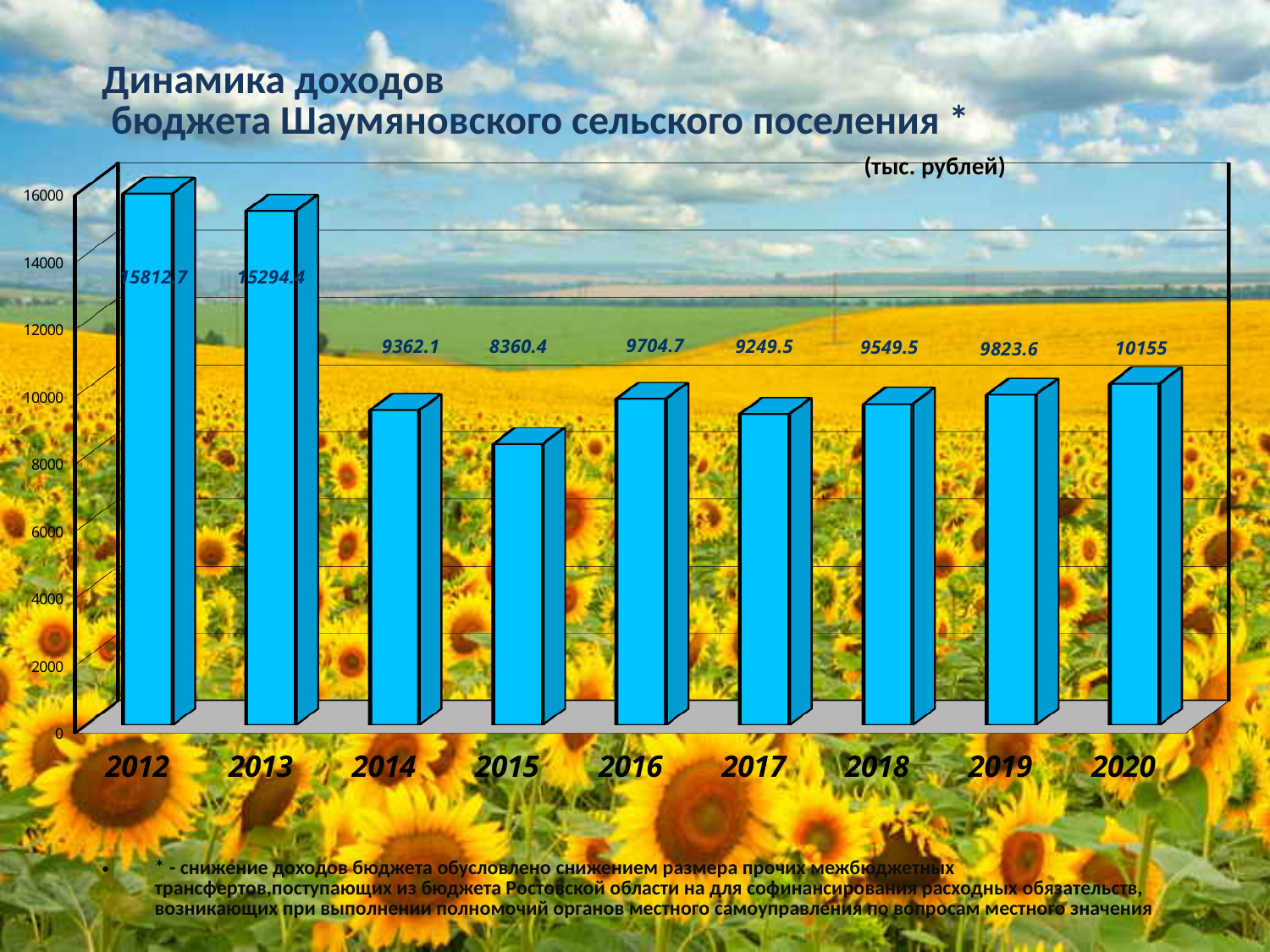
What is the value shown for 2020? 10155 How many years are shown on the x axis? 9 Which year has the lowest value on the chart? 2015 What is the budget income value shown for 2012? 15812.7 Do the values rise or fall from 2017 to 2020? rise What kind of chart is shown on the slide? bar chart Which year has the larger value, 2016 or 2017? 2016 What is the difference between the values for 2020 and 2019? 331.4 What is the value shown for 2015? 8360.4 Is the value for 2014 greater or less than 10000? less Which year has the highest value on the chart? 2012 What is the difference between the values for 2012 and 2013? 518.3